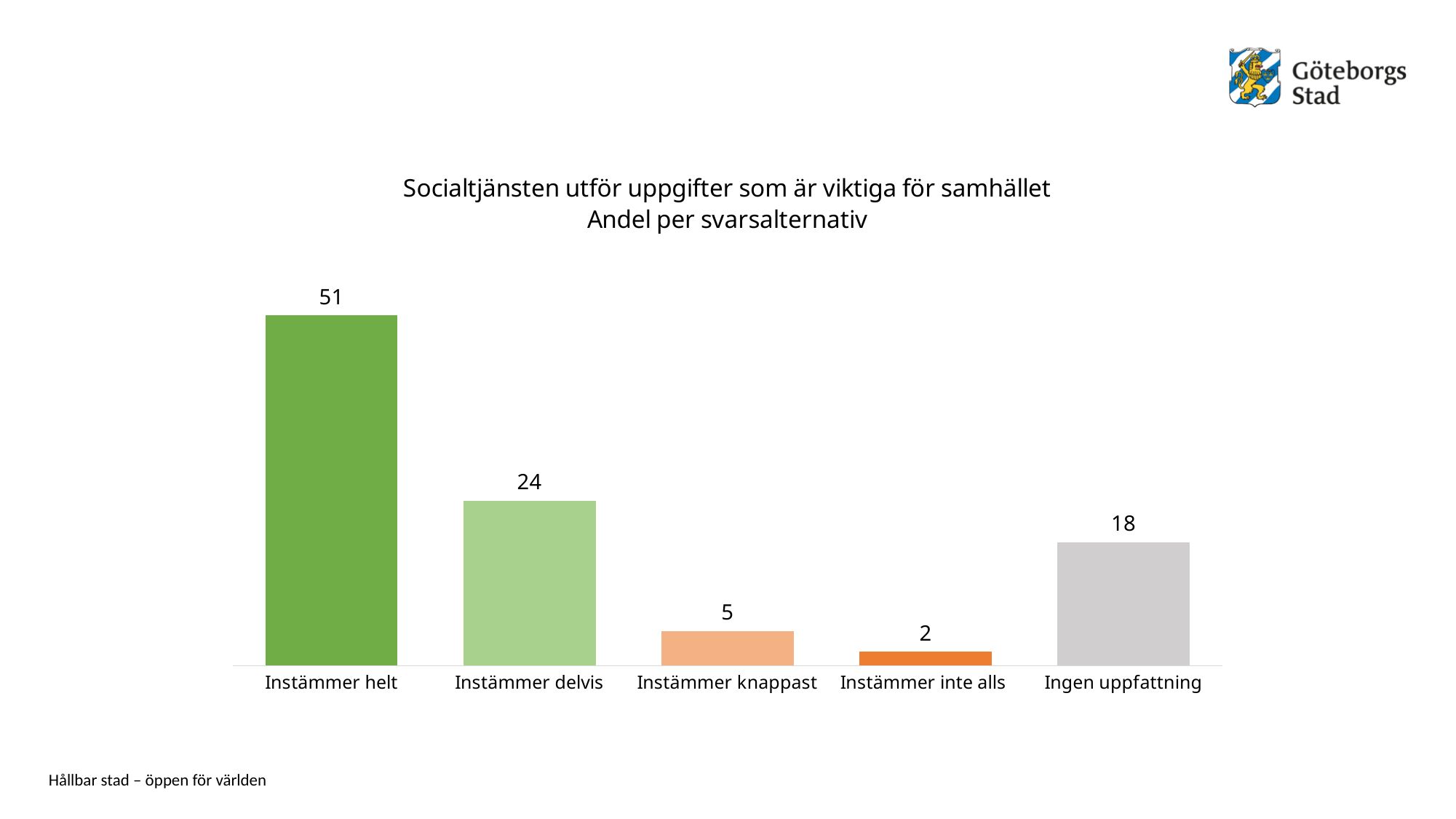
Which category has the highest value? Instämmer helt What is the difference between the values for Instämmer helt and Instämmer delvis? 27 What is the value for Instämmer helt? 51 What is the difference between the values for Ingen uppfattning and Instämmer knappast? 13 Which category has the lowest value? Instämmer inte alls What is the value for Ingen uppfattning? 18 What is the value for Instämmer delvis? 24 How many categories are shown on the x axis? 5 What kind of chart is shown on the slide? Bar chart What is the title of the chart? Socialtjänsten utför uppgifter som är viktiga för samhället Andel per svarsalternativ What is the value for Instämmer inte alls? 2 Which is larger, the value for Instämmer delvis or the value for Ingen uppfattning? Instämmer delvis